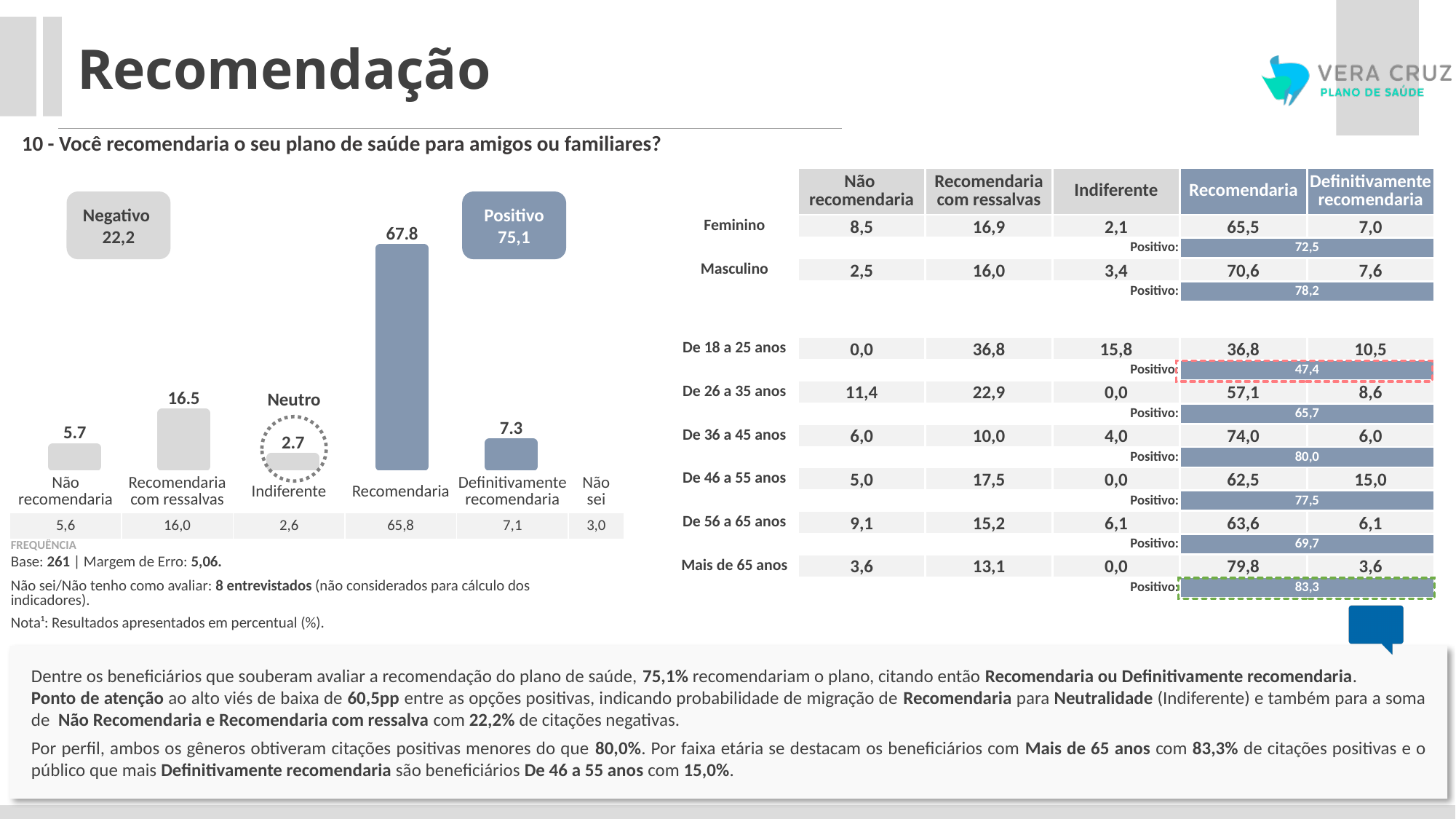
In the bar chart, what value is shown for Definitivamente recomendaria? 7.3 In the bar chart, what value is shown for Indiferente? 2.7 In the bar chart, which is larger: Não recomendaria or Definitivamente recomendaria? Definitivamente recomendaria Which category has the lowest bar in the bar chart? Indiferente In the bar chart, what value is shown for Recomendaria com ressalvas? 16.5 What kind of chart is shown on the left of the slide? Bar chart What label appears above the Indiferente bar in the bar chart? Neutro In the bar chart, what value is shown for Recomendaria? 67.8 In the bar chart, what is the difference between the values for Recomendaria and Definitivamente recomendaria? 60.5 How many bars are plotted in the bar chart? 5 Which category has the highest bar in the bar chart? Recomendaria What value is shown in the Positivo box above the bar chart? 75,1